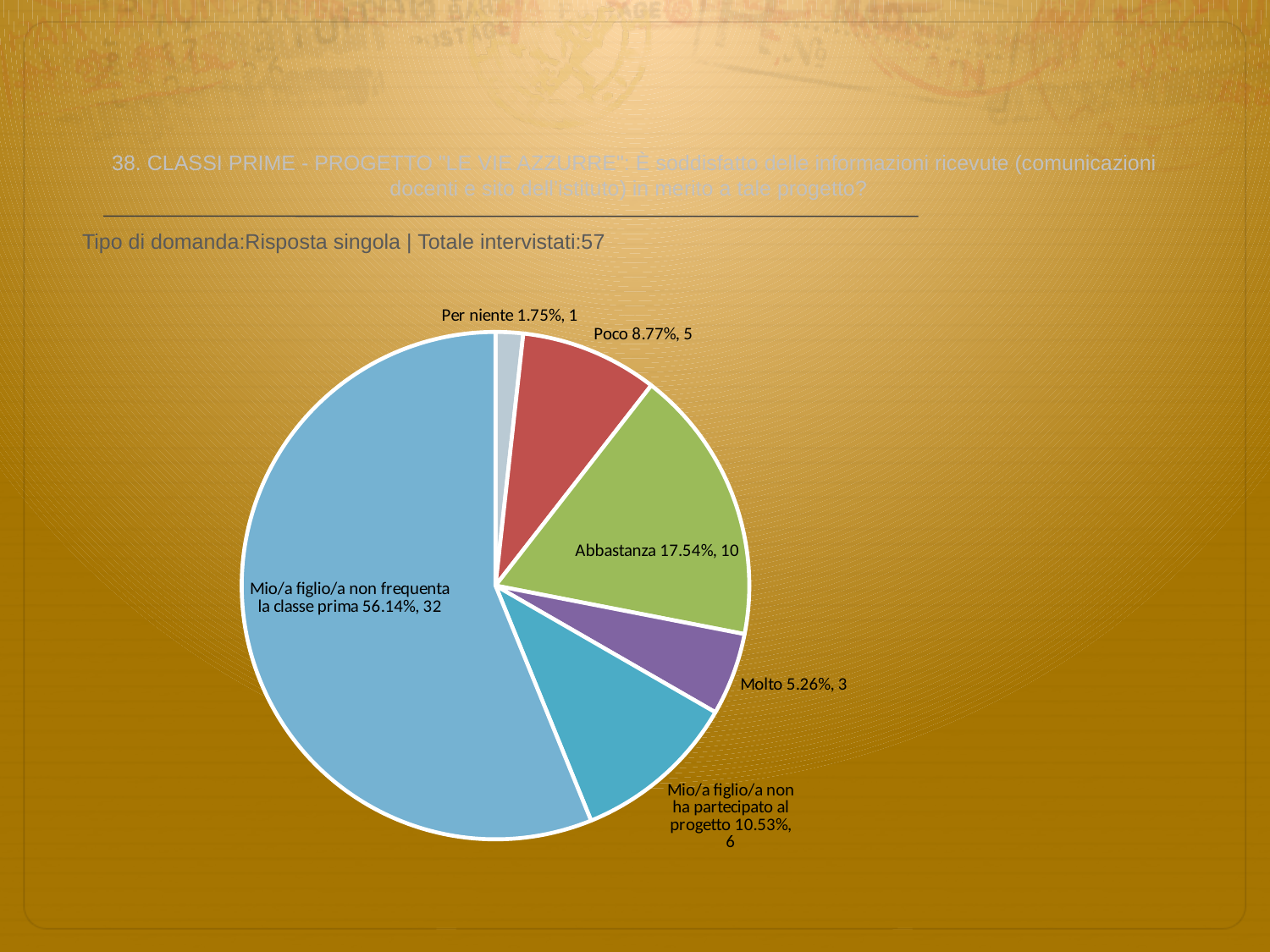
What is the difference in number of respondents between "Abbastanza" and "Poco"? 5 Which category has the smallest slice of the pie? Per niente What percentage share does the "Mio/a figlio/a non frequenta la classe prima" slice represent? 56.14% What kind of chart is shown on the slide? pie chart How many respondents answered "Molto"? 3 What colour is the "Poco" slice of the pie chart? red How many slices does the pie chart have? 6 Which has more respondents, "Mio/a figlio/a non ha partecipato al progetto" or "Molto"? Mio/a figlio/a non ha partecipato al progetto How many respondents answered "Poco"? 5 What is the total number of respondents (Totale intervistati) stated on the slide? 57 What percentage share does the "Abbastanza" slice represent? 17.54% Which category has the largest slice of the pie? Mio/a figlio/a non frequenta la classe prima